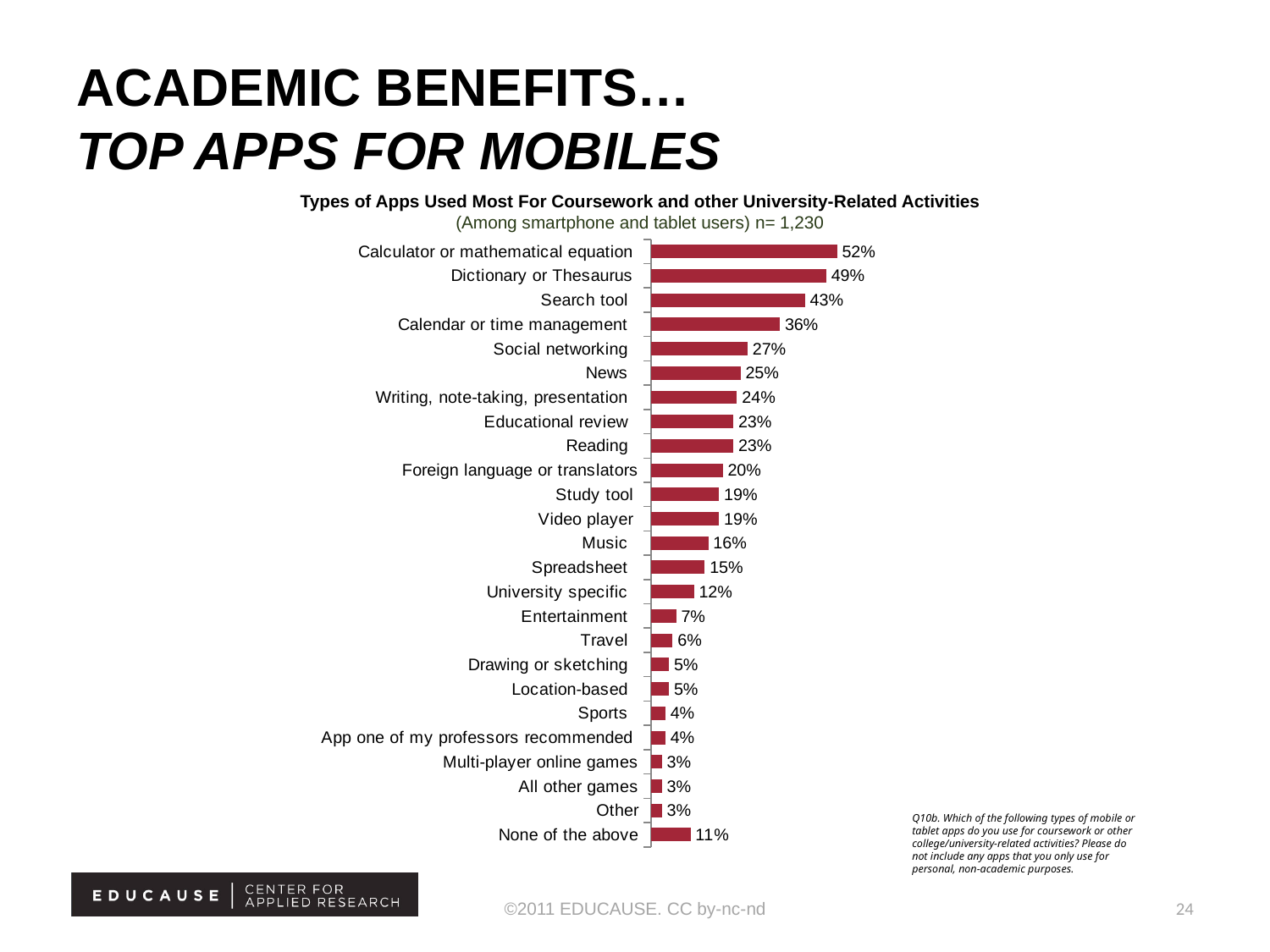
What percentage of respondents use a calculator or mathematical equation app? 52% What is the difference between Dictionary or Thesaurus and Search tool? 6% What is the value for Study tool? 19% What is the sample size (n) stated in the chart subtitle? 1,230 Which is larger, Calendar or time management or News? Calendar or time management What percentage is shown for None of the above? 11% Which type of app has the highest percentage? Calculator or mathematical equation How many categories are shown in the chart? 25 What is the title of the chart? Types of Apps Used Most For Coursework and other University-Related Activities What is the difference between Spreadsheet and University specific? 3% What kind of chart is shown on the slide? Bar chart What is the value for Social networking? 27%